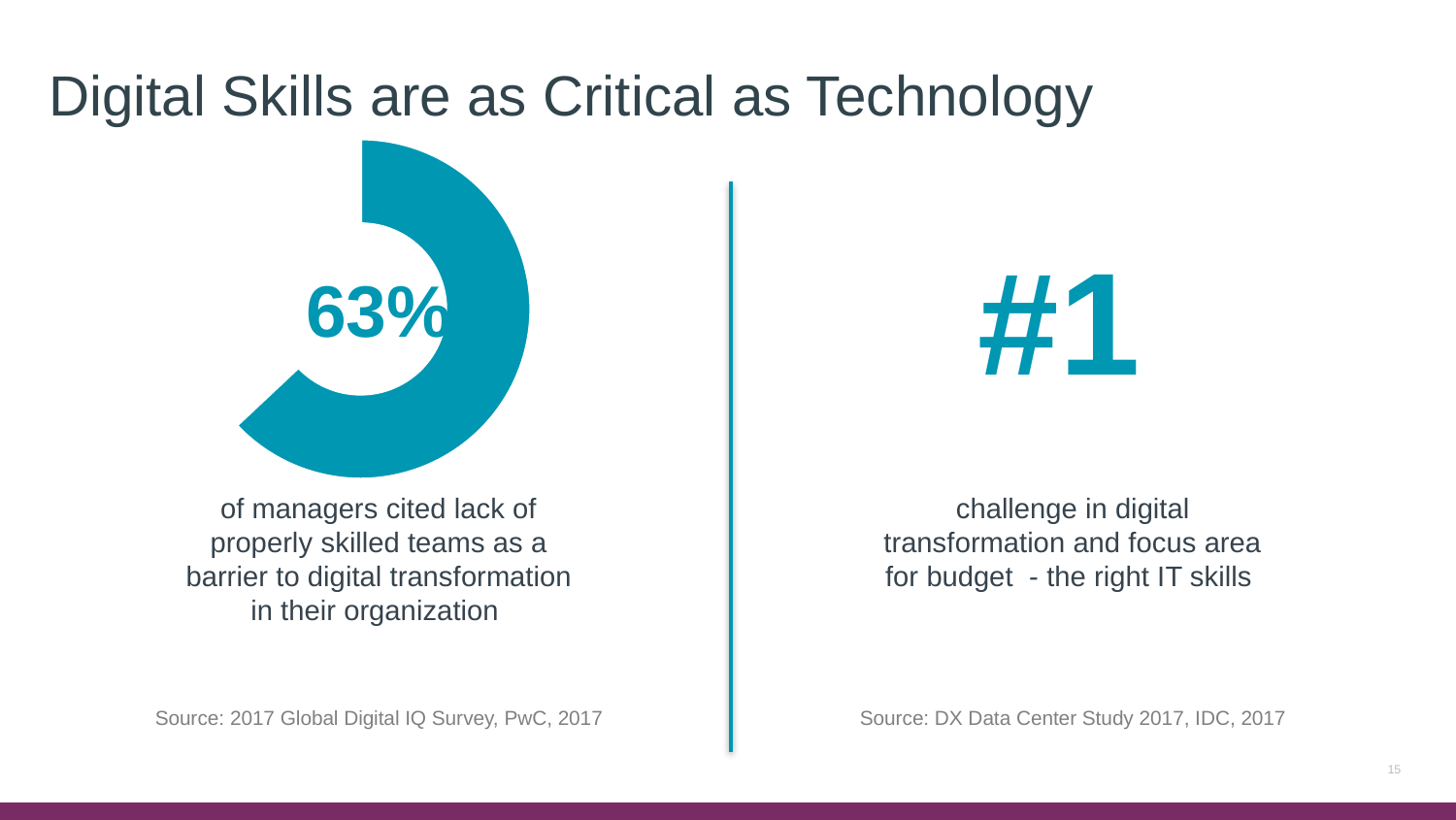
What percentage is shown in the centre of the doughnut chart on the left? 63% What share of the doughnut chart is filled in teal? 63% Is the value shown in the doughnut chart greater or less than 50%? greater What colour is the filled segment of the doughnut chart? Teal What is the source cited for the doughnut chart on the left? 2017 Global Digital IQ Survey, PwC, 2017 According to the doughnut chart, what percentage of managers cited lack of properly skilled teams as a barrier to digital transformation? 63% What kind of chart is shown on the left side of the slide? Doughnut chart